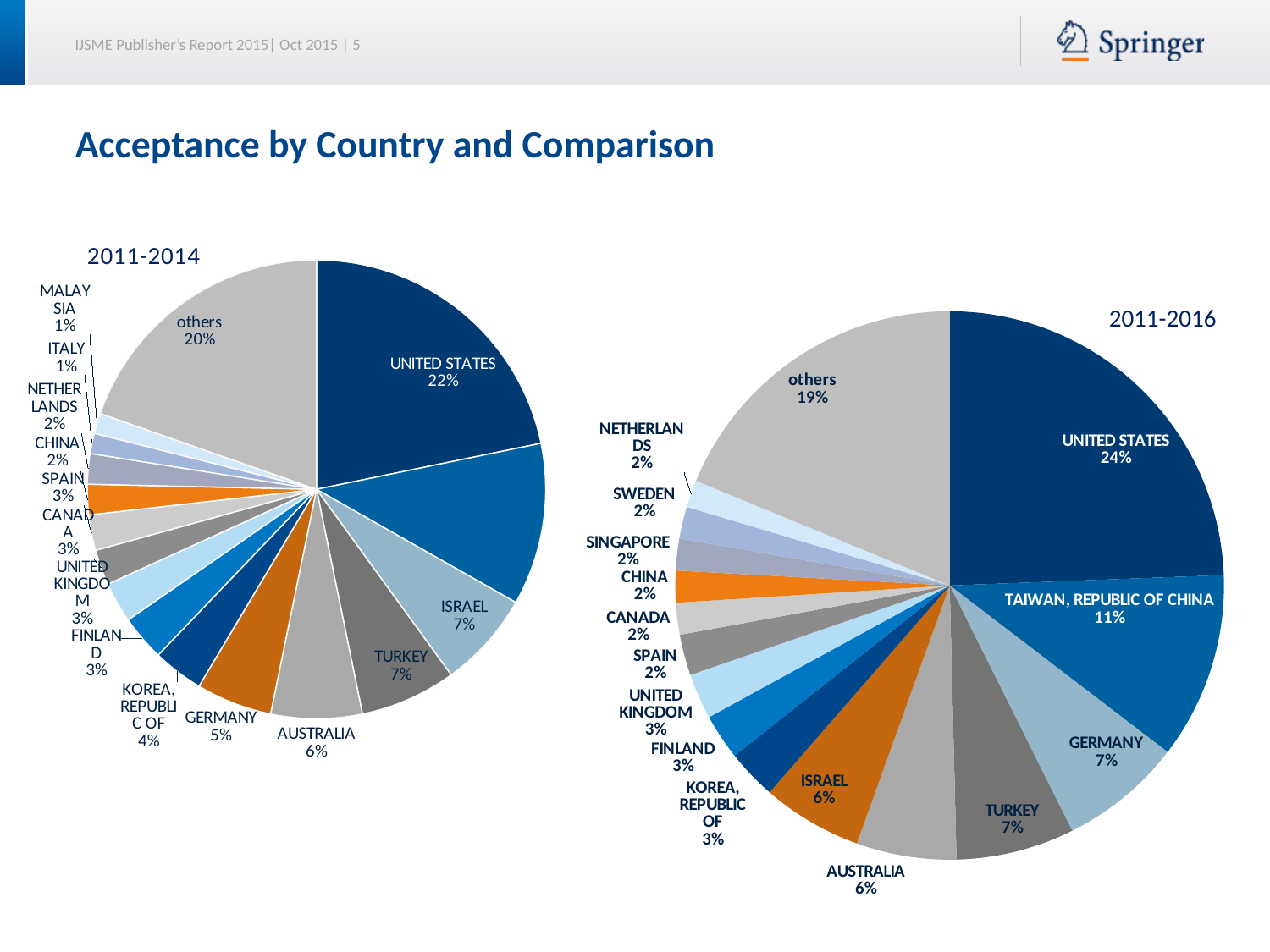
In the 2011-2016 pie chart, what share does ISRAEL have? 6% How many slices does the 2011-2016 pie chart have? 16 What is the difference between the UNITED STATES share in the 2011-2016 pie chart and in the 2011-2014 pie chart? 2% In the 2011-2014 pie chart, what share does UNITED STATES have? 22% What kind of chart is the 2011-2014 chart? Pie chart In the 2011-2014 pie chart, what share does GERMANY have? 5% In the 2011-2014 pie chart, which is larger, the share for AUSTRALIA or the share for GERMANY? AUSTRALIA In the 2011-2016 pie chart, what share does the 'others' slice have? 19% In the 2011-2016 pie chart, which is larger, the share for TAIWAN, REPUBLIC OF CHINA or the share for GERMANY? TAIWAN, REPUBLIC OF CHINA In the 2011-2014 pie chart, which named country has the largest share? UNITED STATES In the 2011-2016 pie chart, which named country has the largest share? UNITED STATES In the 2011-2016 pie chart, what share does TAIWAN, REPUBLIC OF CHINA have? 11%